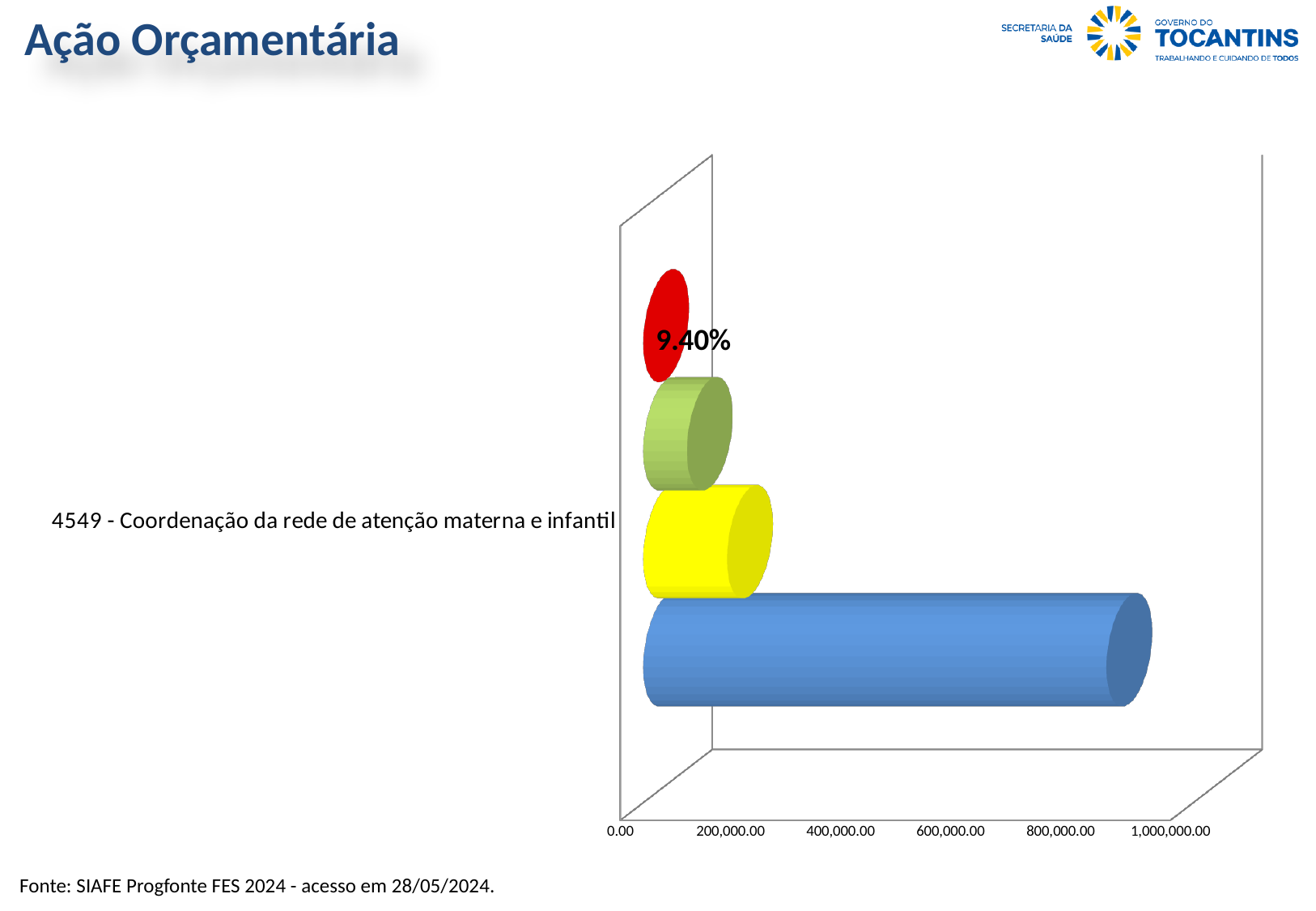
How many bars are plotted for the category 4549 - Coordenação da rede de atenção materna e infantil? 4 Which is larger, the blue bar or the yellow bar? blue bar How many categories are shown on the vertical axis of the chart? 1 Is the value of the red bar greater or less than 200,000.00? less Is the value of the blue bar greater or less than 800,000.00? greater What is the category label shown on the chart? 4549 - Coordenação da rede de atenção materna e infantil Which coloured bar is the longest in the chart? blue What is the highest value shown on the horizontal axis of the chart? 1,000,000.00 What value is printed as a data label on the red bar? 9.40% What kind of chart is shown on the slide? bar chart Which coloured bar is the shortest in the chart? red What is the title of the slide containing the chart? Ação Orçamentária